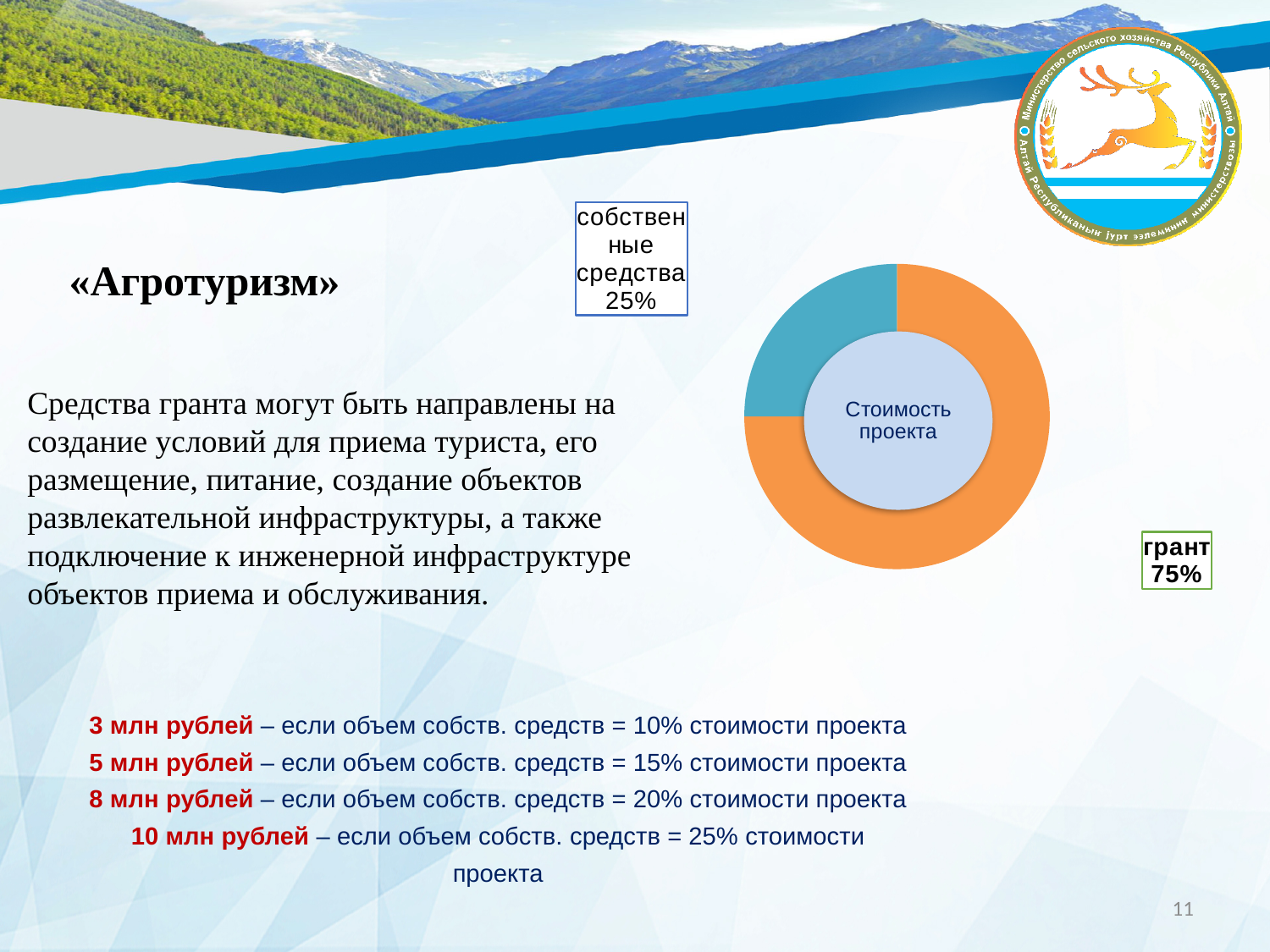
What is the total of the two slices shown in the chart? 100% What colour is the slice representing the grant (грант 75%)? orange What share of the project cost do own funds (собственные средства) represent in the chart? 25% Which is larger in the chart: the grant share or the own-funds share? грант What is the difference in percentage points between the grant share and the own-funds share? 50 Which slice of the chart is the largest? грант How many slices does the chart have? 2 What share of the project cost does the grant (грант) represent in the chart? 75% Which slice of the chart is the smallest? собственные средства What label is shown in the centre of the doughnut chart? Стоимость проекта What kind of chart is shown on the slide? doughnut chart